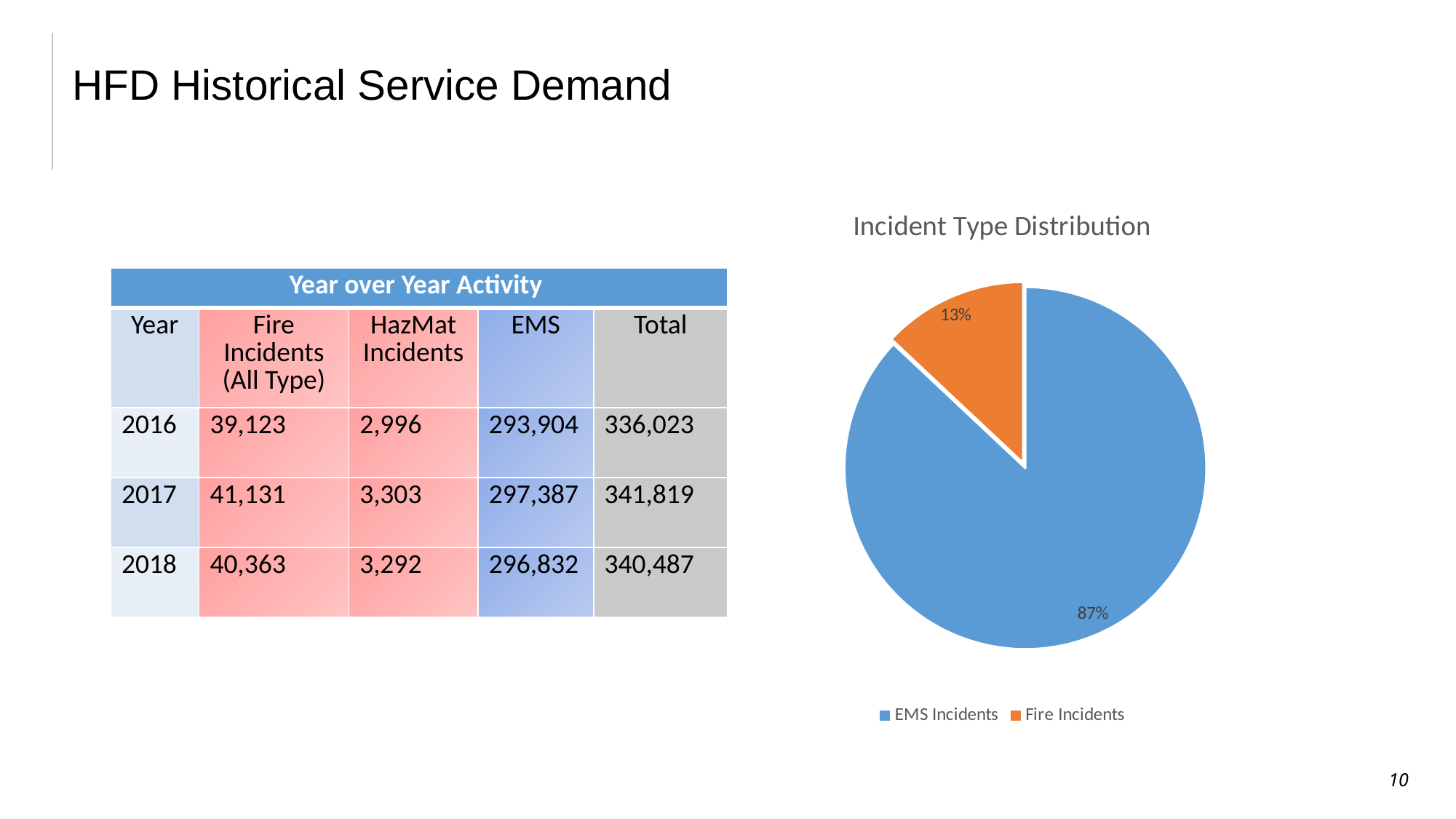
What is the title of the pie chart? Incident Type Distribution In the pie chart, which is larger, EMS Incidents or Fire Incidents? EMS Incidents What share of the pie chart is Fire Incidents? 13% What share of the pie chart is EMS Incidents? 87% How many entries does the pie chart's legend list? 2 What kind of chart is the Incident Type Distribution chart? pie chart What colour is the Fire Incidents slice in the pie chart? orange Which slice of the pie chart is the largest? EMS Incidents How many slices does the pie chart have? 2 What is the difference in percentage points between the EMS Incidents and Fire Incidents slices? 74 Which slice of the pie chart is the smallest? Fire Incidents